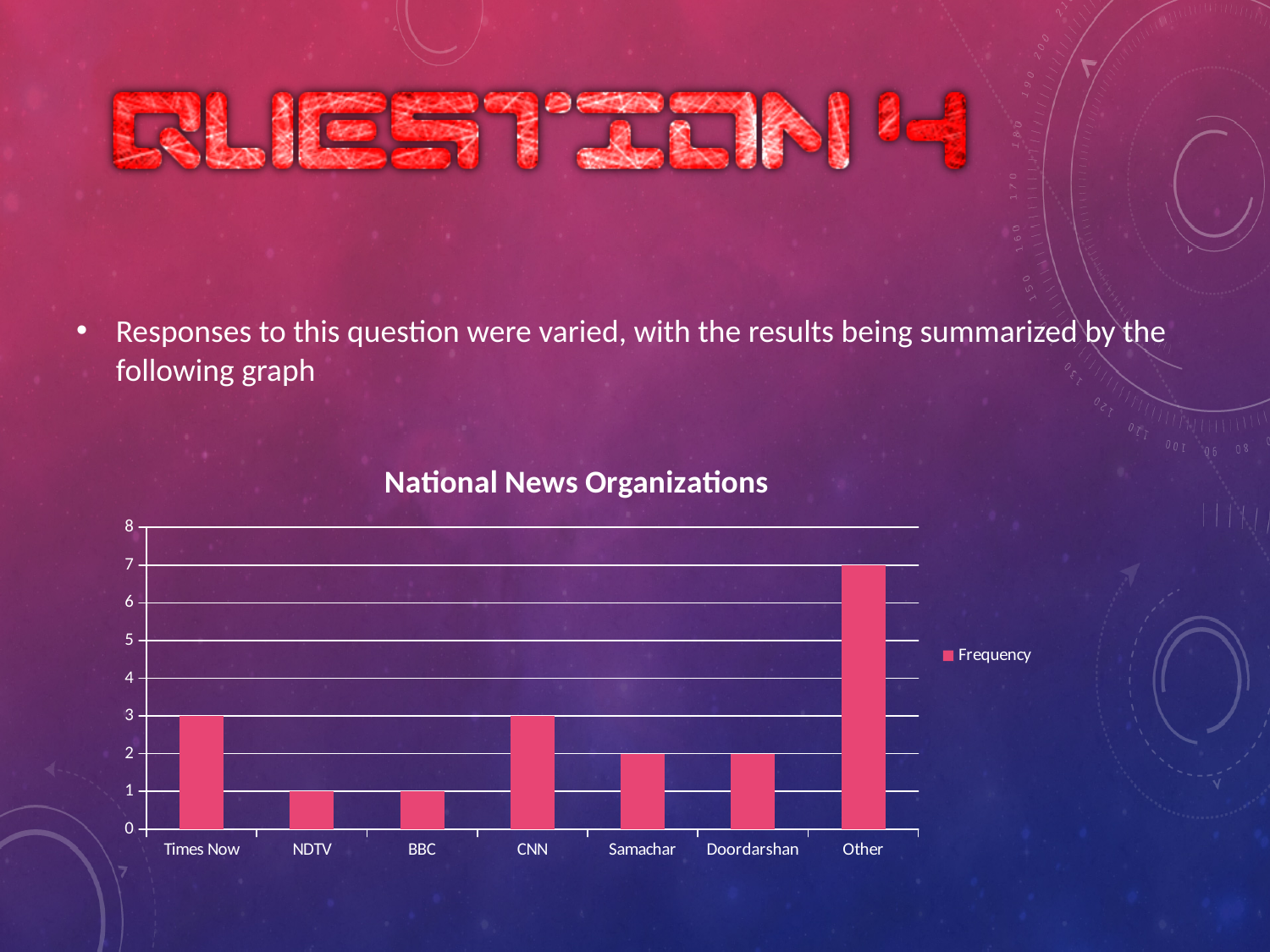
Which category has the highest frequency? Other What is the title of the chart? National News Organizations What is the frequency for Times Now? 3 What type of chart is shown on the slide? bar chart What is the frequency for Samachar? 2 Which is larger, the frequency for Doordarshan or the frequency for NDTV? Doordarshan What is the difference between the frequency for Other and the frequency for CNN? 4 Is the value for Other greater or less than 5? greater What is the frequency for Other? 7 How many categories are shown on the x axis of the chart? 7 How many series does the legend list? 1 What is the name of the series shown in the legend? Frequency